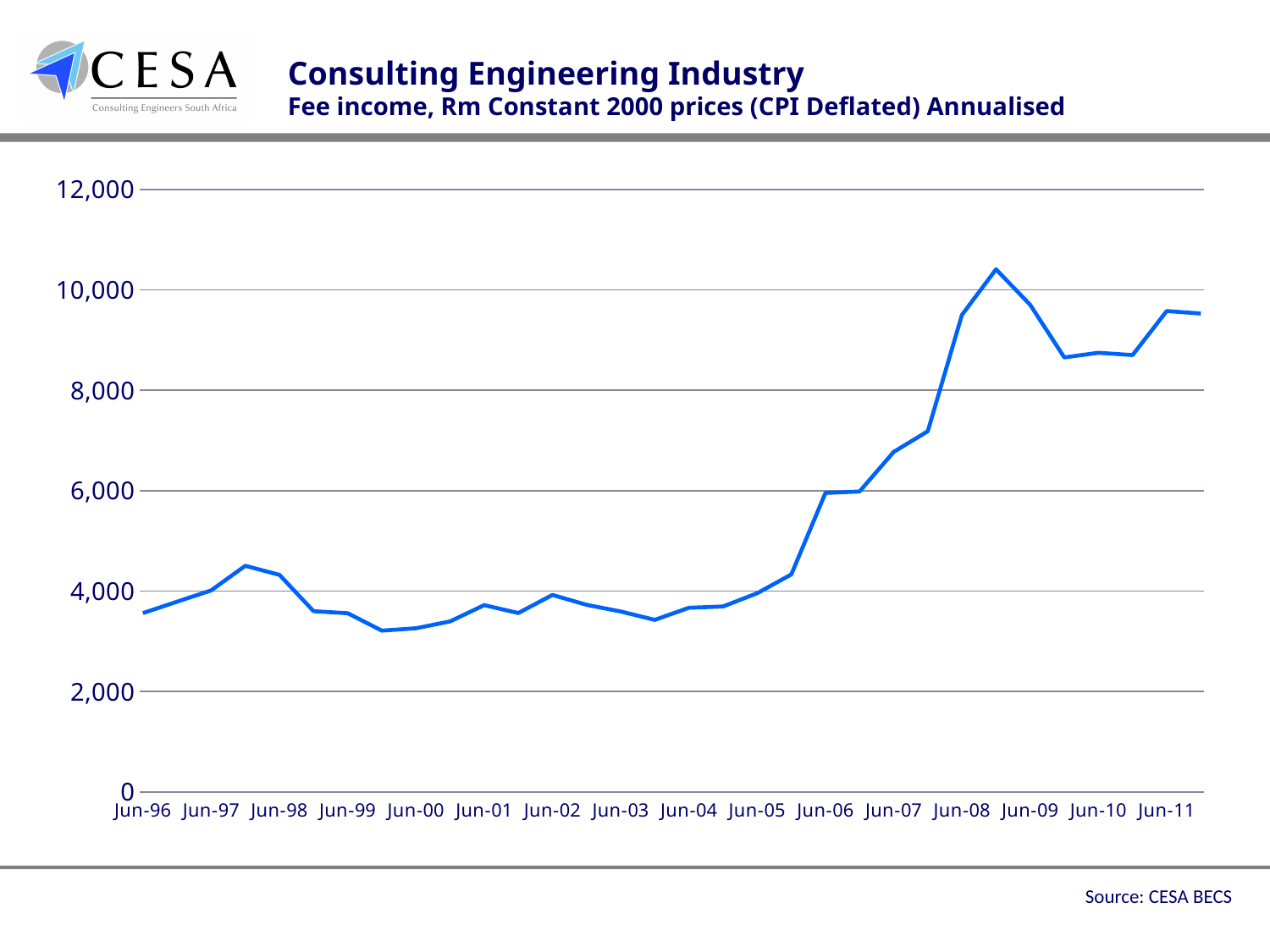
Is the lowest point on the line greater or less than 4,000? less Is the highest point on the line greater or less than 10,000? greater Is the fee income value for Jun-11 greater or less than 8,000? greater What is the source cited for the chart? CESA BECS What kind of chart is shown on the slide? line chart Overall, does the fee income rise or fall from Jun-96 to Jun-11? rise Does the fee income rise or fall between Jun-06 and Jun-08? rise How many year labels are shown along the x axis? 16 Which is larger, the fee income at Jun-08 or at Jun-03? Jun-08